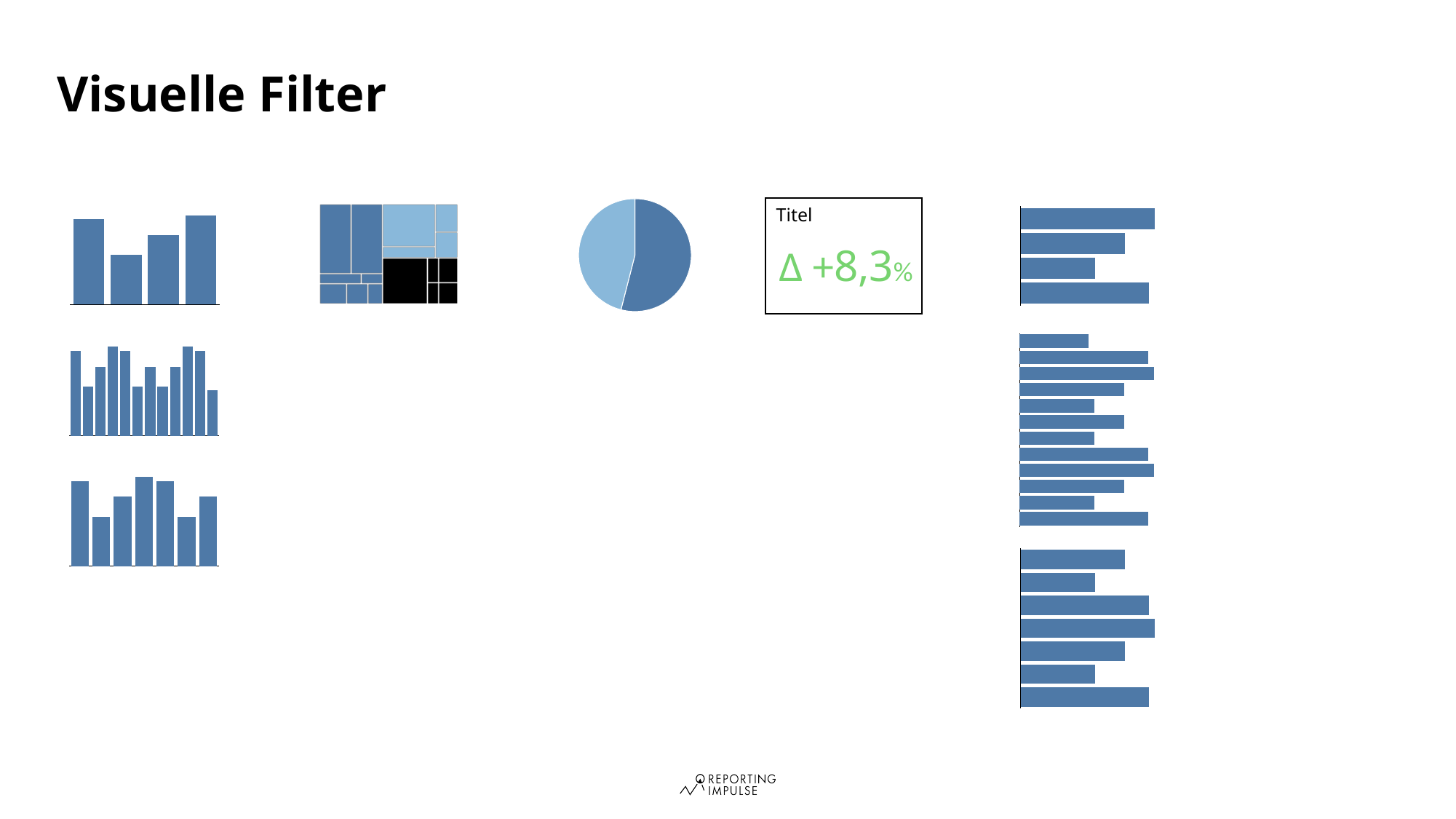
What value is displayed in the KPI box labelled 'Titel'? Δ +8,3% How many bars does the topmost horizontal bar chart on the right side of the slide have? 4 What kind of chart is shown at the top left of the slide? bar chart How many slices does the pie chart have? 2 How many bars does the bottom horizontal bar chart on the right side of the slide have? 7 What is the title of the slide? Visuelle Filter In the top-left bar chart, which bar is the tallest, counting from the left? the fourth In the top-left bar chart, which bar is the shortest, counting from the left? the second What kind of chart is shown in the centre of the slide, to the right of the treemap? pie chart